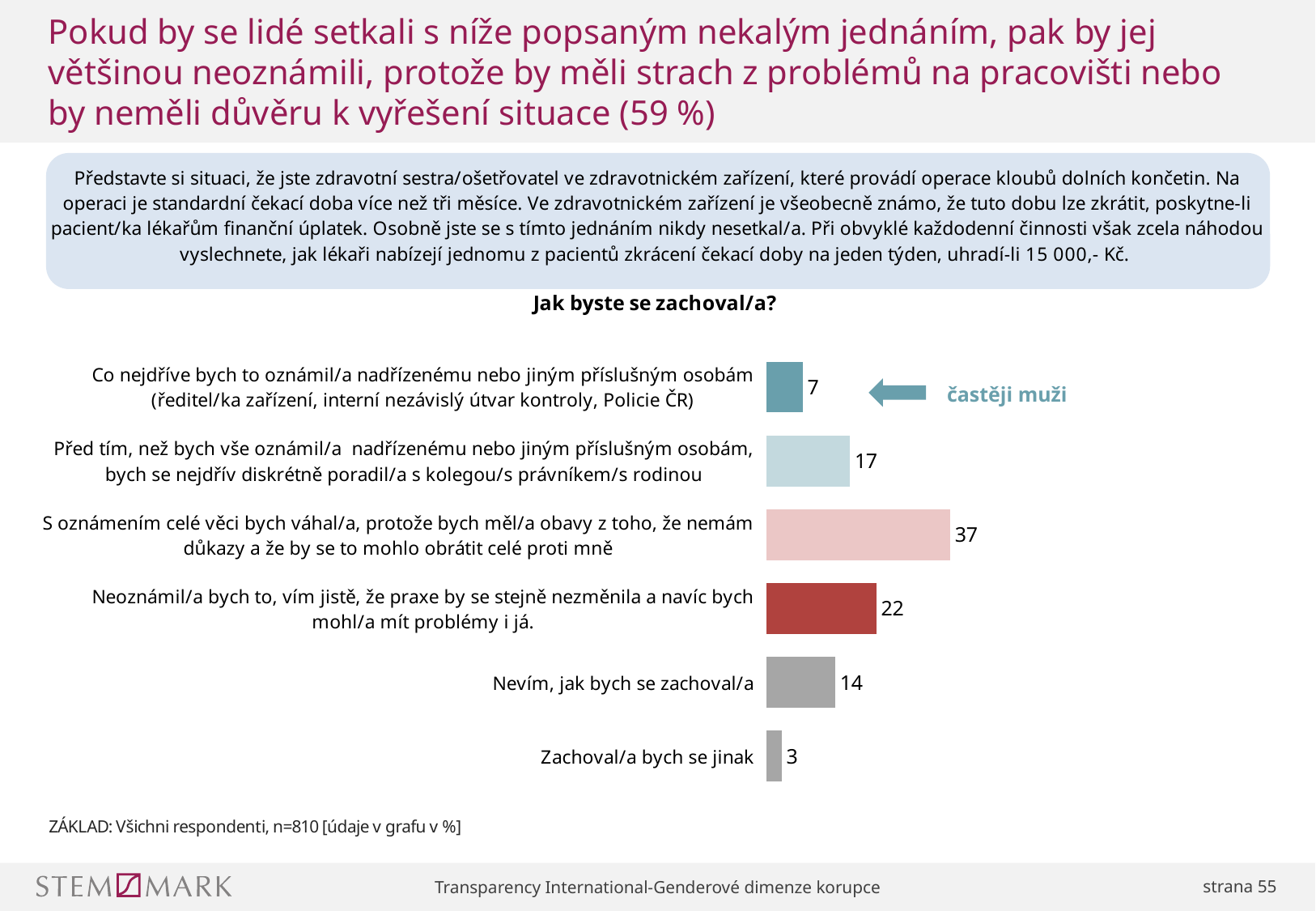
Which category has the lowest value in the chart? Zachoval/a bych se jinak What value is shown for "Nevím, jak bych se zachoval/a"? 14 What value is shown for "Zachoval/a bych se jinak"? 3 What value is shown for the bar "Co nejdříve bych to oznámil/a nadřízenému nebo jiným příslušným osobám"? 7 What is the difference between the value for "S oznámením celé věci bych váhal/a..." (37) and the value for "Neoznámil/a bych to..." (22)? 15 What value is shown for the bar "Neoznámil/a bych to, vím jistě, že praxe by se stejně nezměnila a navíc bych mohl/a mít problémy i já."? 22 Which category has the highest value in the chart? S oznámením celé věci bych váhal/a, protože bych měl/a obavy z toho, že nemám důkazy a že by se to mohlo obrátit celé proti mně Which is larger: the value for "Před tím, než bych vše oznámil/a..." or the value for "Nevím, jak bych se zachoval/a"? Před tím, než bych vše oznámil/a nadřízenému nebo jiným příslušným osobám, bych se nejdřív diskrétně poradil/a s kolegou/s právníkem/s rodinou What is the title of the chart? Jak byste se zachoval/a? How many categories (bars) does the chart show? 6 What kind of chart is shown on the slide? Bar chart What is the sum of the values for "Co nejdříve bych to oznámil/a..." (7) and "Před tím, než bych vše oznámil/a..." (17)? 24